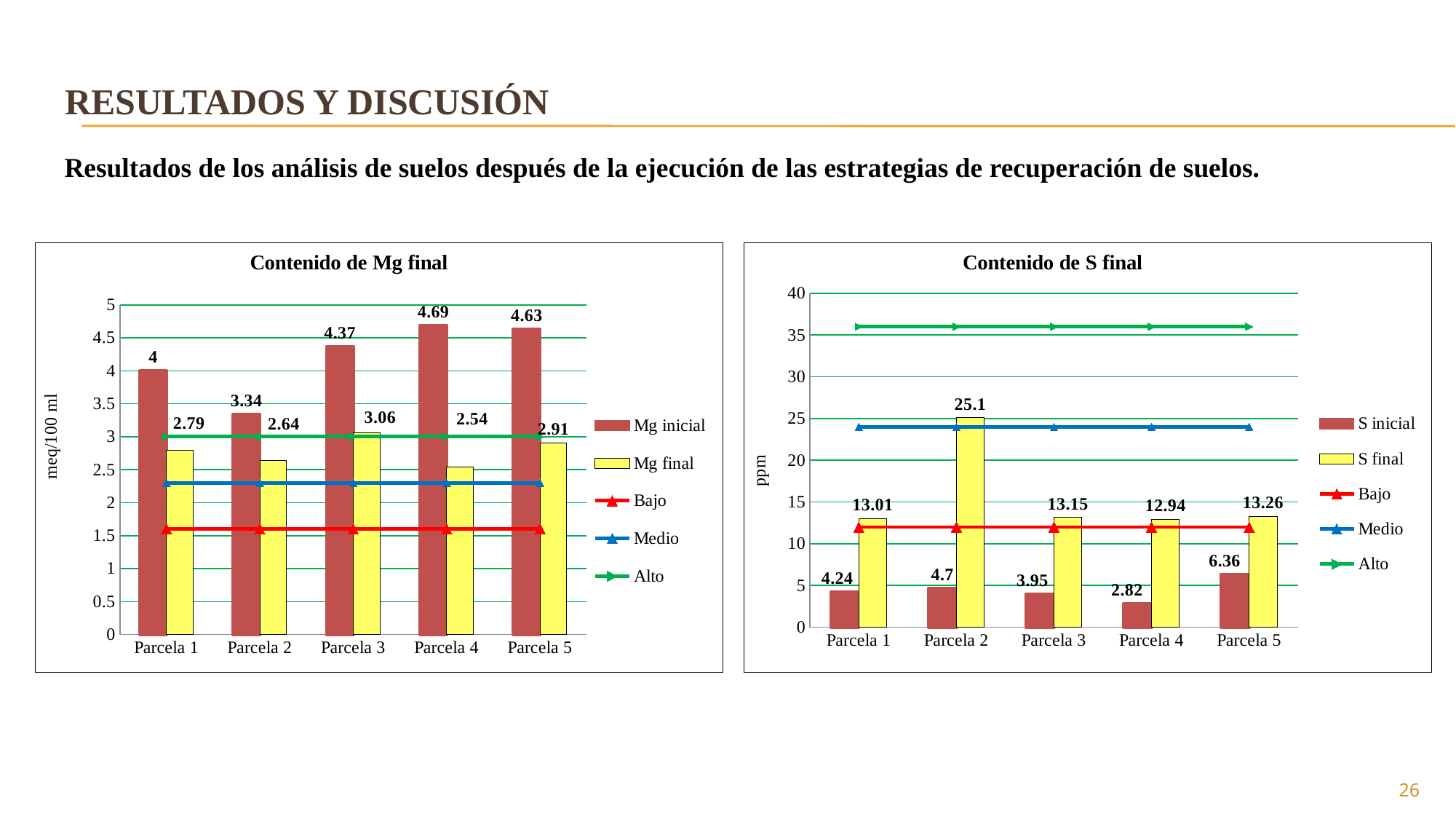
In the 'Contenido de S final' chart, which parcela has the lowest S inicial value? Parcela 4 In the 'Contenido de S final' chart, what is the S final value for Parcela 2? 25.1 In the 'Contenido de Mg final' chart, which parcela has the highest Mg inicial value? Parcela 4 How many parcelas are shown on the x axis of the 'Contenido de S final' chart? 5 In the 'Contenido de Mg final' chart, what is the difference between Mg inicial and Mg final for Parcela 1? 1.21 In the 'Contenido de Mg final' chart, is the Medio line greater or less than 2? greater In the 'Contenido de S final' chart, is the Alto line greater or less than 35? greater In the 'Contenido de S final' chart, what is the difference between S final and S inicial for Parcela 2? 20.4 What is the y-axis label of the 'Contenido de S final' chart? ppm In the 'Contenido de S final' chart, which is larger, the S inicial value for Parcela 5 or for Parcela 1? Parcela 5 In the 'Contenido de Mg final' chart, what is the Mg inicial value for Parcela 3? 4.37 How many series does the legend of the 'Contenido de Mg final' chart list? 5